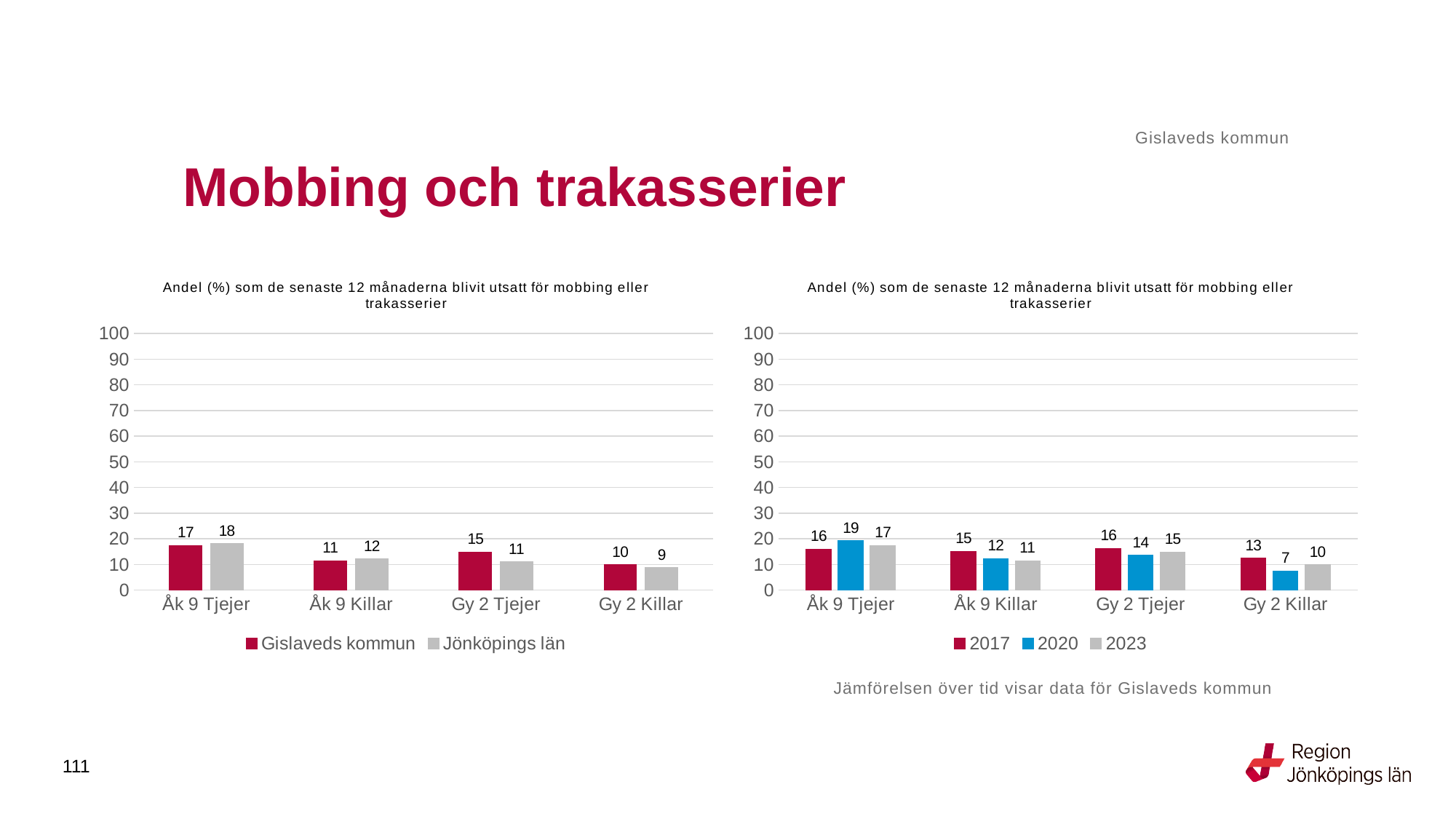
In the left chart, what is the difference between Gislaveds kommun and Jönköpings län for Gy 2 Tjejer? 4 In the right chart, which category has the lowest value for 2020? Gy 2 Killar In the right chart, what is the difference between the 2017 and 2020 values for Gy 2 Killar? 6 In the right chart, which is larger for Åk 9 Killar: the 2017 value or the 2023 value? 2017 In the right chart, what is the value for 2020 for Åk 9 Tjejer? 19 In the right chart, what is the value for 2023 for Gy 2 Killar? 10 In the right chart, how many categories are shown on the x axis? 4 What kind of chart is the right chart? Bar chart In the left chart, what is the value for Jönköpings län for Gy 2 Killar? 9 In the left chart, which category has the highest value for Jönköpings län? Åk 9 Tjejer In the left chart, what is the value for Gislaveds kommun for Åk 9 Tjejer? 17 In the left chart, how many series does the legend list? 2